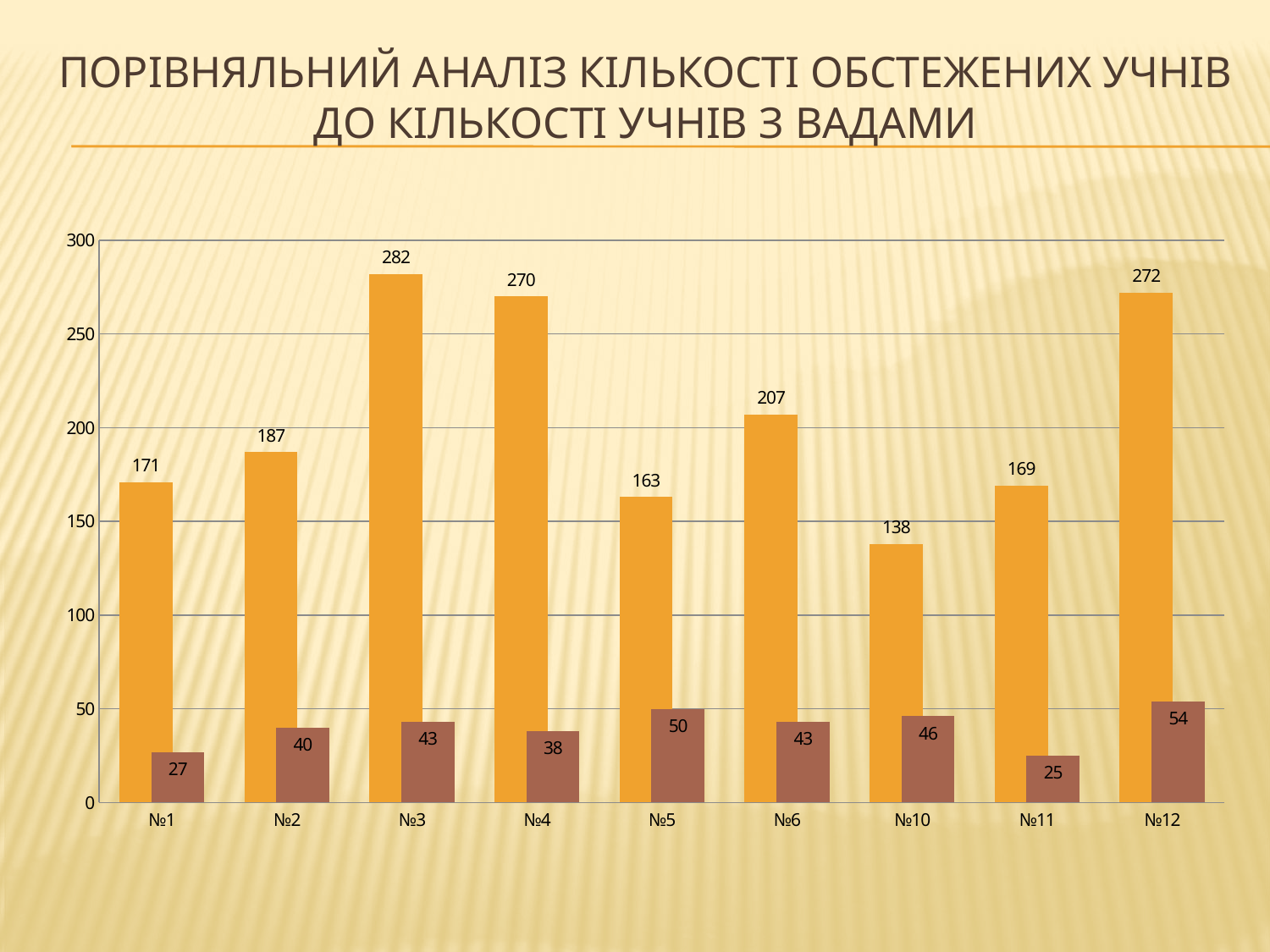
Which category has the highest orange bar? №3 Which category has the lowest brown bar? №11 What is the highest value shown on the vertical axis? 300 Which category has the lowest orange bar? №10 What is the value of the orange bar for №3? 282 What is the value of the orange bar for №10? 138 What is the difference between the orange bar values for №3 and №4? 12 What is the value of the brown bar for №12? 54 What is the difference between the brown bar values for №12 and №1? 27 Which is larger, the orange bar for №2 or the orange bar for №6? №6 What kind of chart is shown on the slide? Bar chart How many categories are shown on the x axis? 9